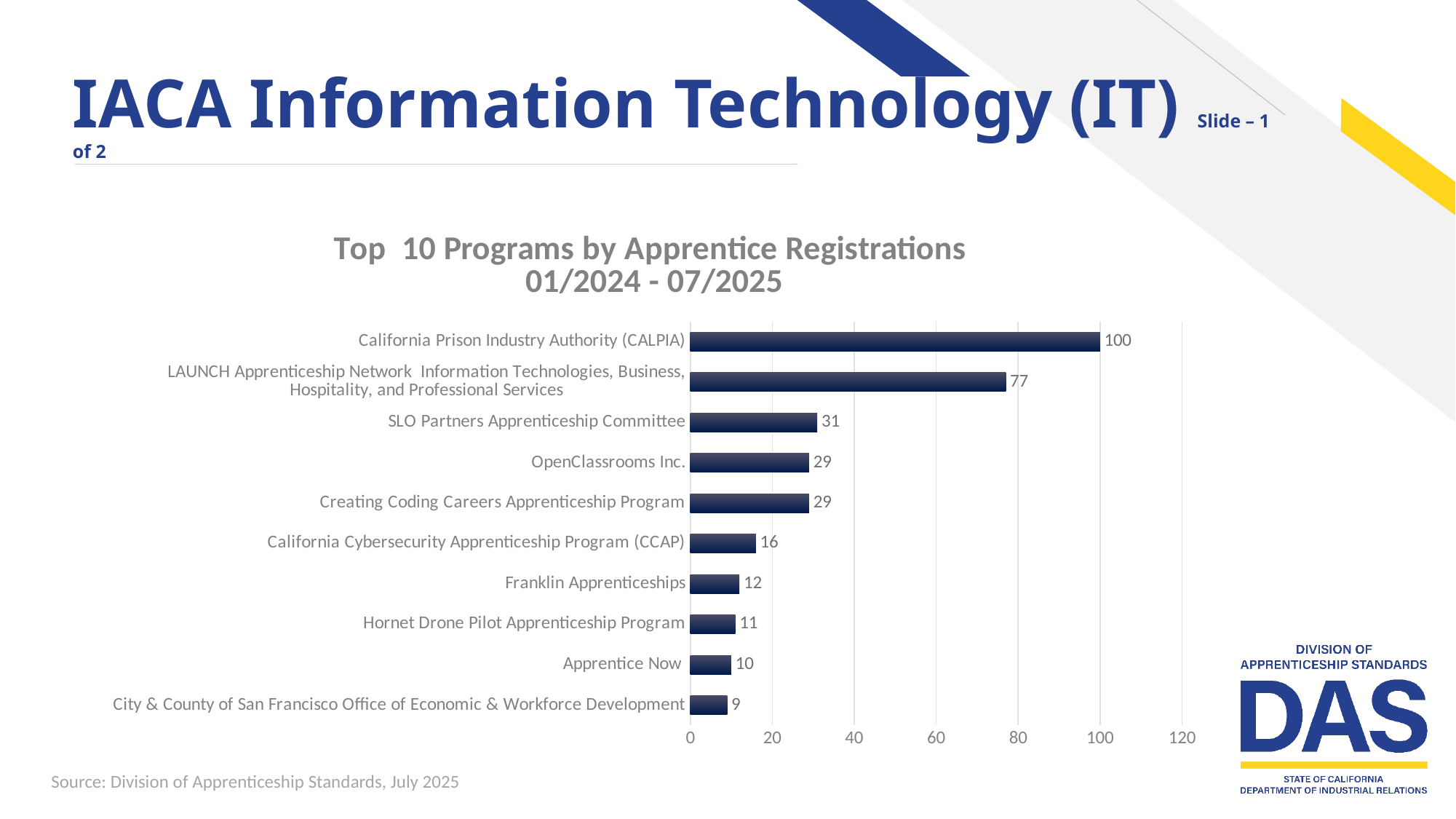
What is the title of the chart? Top 10 Programs by Apprentice Registrations 01/2024 - 07/2025 Which program has the highest number of apprentice registrations? California Prison Industry Authority (CALPIA) What is the value for Hornet Drone Pilot Apprenticeship Program? 11 Which has more apprentice registrations, SLO Partners Apprenticeship Committee or OpenClassrooms Inc.? SLO Partners Apprenticeship Committee What is the difference between the values for California Prison Industry Authority (CALPIA) and LAUNCH Apprenticeship Network Information Technologies, Business, Hospitality, and Professional Services? 23 How many programs are shown in the chart? 10 What kind of chart is shown on the slide? bar chart Which program has the lowest number of apprentice registrations? City & County of San Francisco Office of Economic & Workforce Development Is the value for LAUNCH Apprenticeship Network Information Technologies, Business, Hospitality, and Professional Services greater or less than 60? greater What is the difference between the values for California Cybersecurity Apprenticeship Program (CCAP) and Franklin Apprenticeships? 4 How many apprentice registrations does California Prison Industry Authority (CALPIA) have? 100 What is the value for SLO Partners Apprenticeship Committee? 31